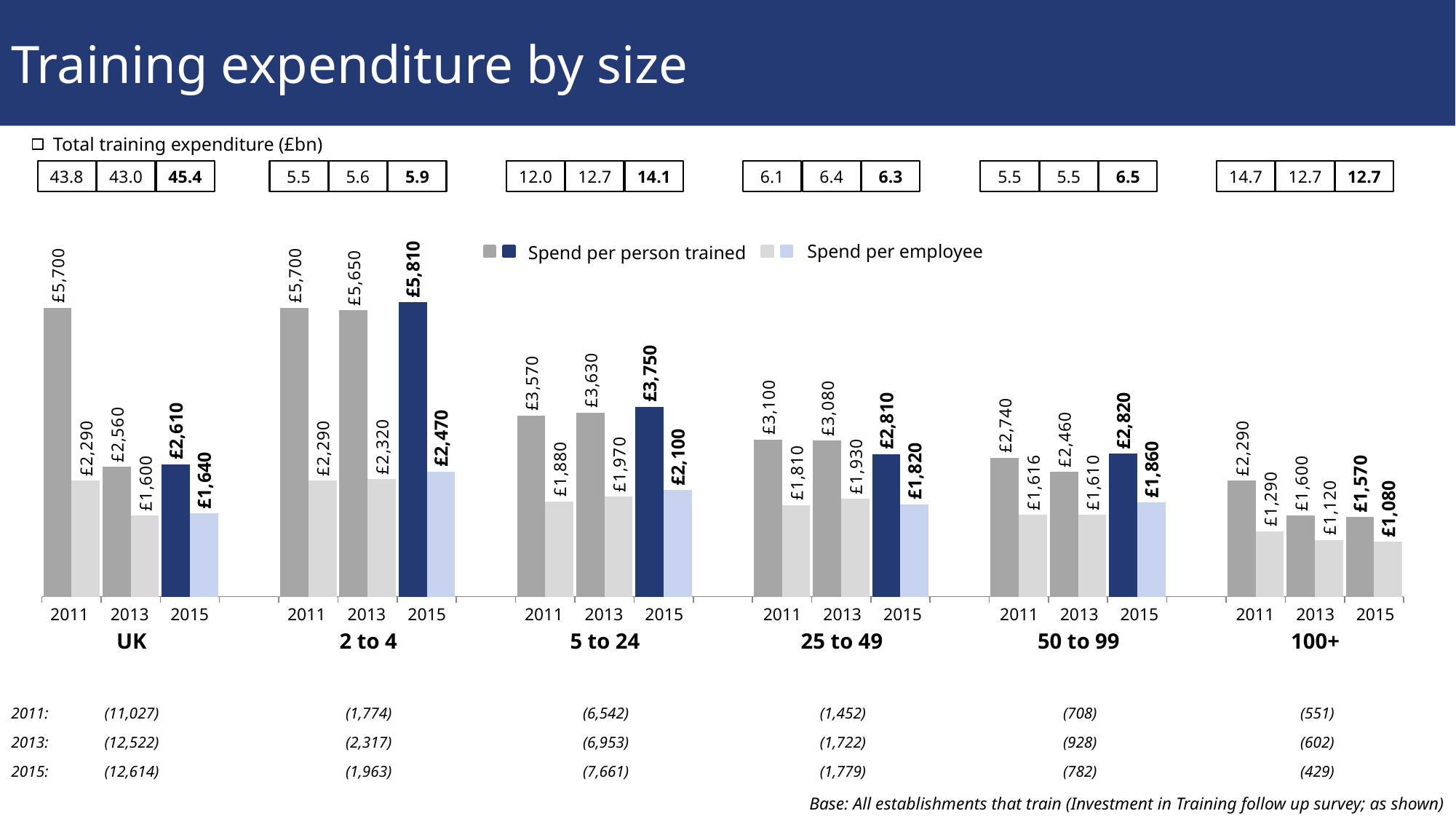
In the 50 to 99 panel, which is larger: spend per person trained in 2013 or in 2015? 2015 In the 5 to 24 panel, does spend per employee rise or fall from 2011 to 2015? Rise In the 2 to 4 panel, what is the spend per employee in 2013? £2,320 How many establishment size groups (panels) are shown on the slide, including UK? 6 What kind of chart is used to show spend per person trained and spend per employee? Bar chart How many series does the chart legend list? 2 In the UK panel, what is the spend per person trained in 2015? £2,610 In the 100+ panel, which year has the lowest spend per employee? 2015 In the 100+ panel, what is the spend per employee in 2015? £1,080 In the 25 to 49 panel, what is the difference between spend per person trained in 2011 and 2015? £290 In the 5 to 24 panel, which year has the highest spend per person trained? 2015 What is the total training expenditure (£bn) shown for the UK in 2015? 45.4